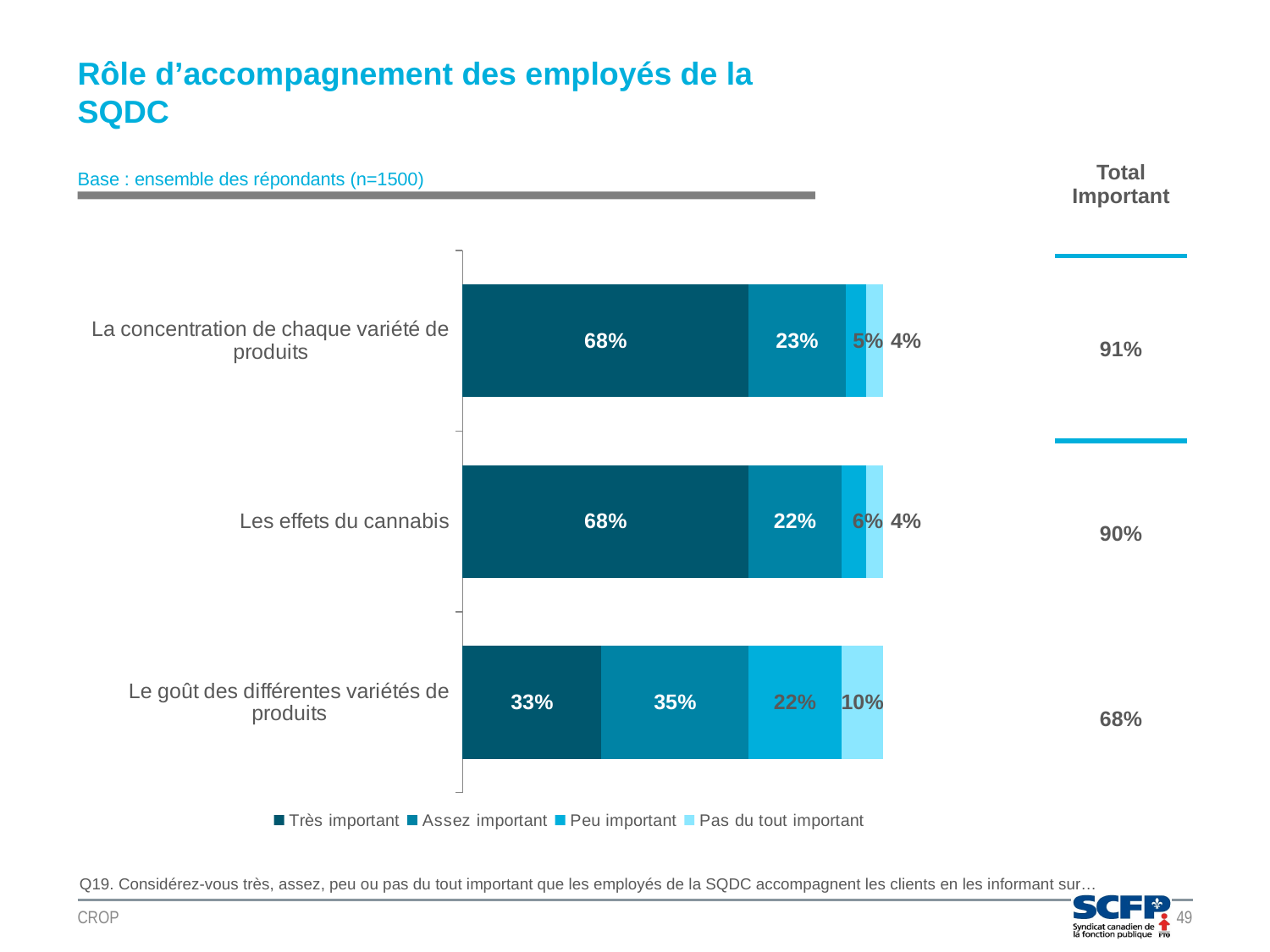
What is the 'Assez important' value for 'Le goût des différentes variétés de produits'? 35% What is the 'Pas du tout important' value for 'La concentration de chaque variété de produits'? 4% What is the 'Très important' value for 'Les effets du cannabis'? 68% How many categories are plotted in the chart? 3 What kind of chart is shown on the slide? stacked bar chart What is the difference between the 'Très important' values for 'Les effets du cannabis' and 'Le goût des différentes variétés de produits'? 35% Which category has the highest 'Pas du tout important' value? Le goût des différentes variétés de produits Which category has the lowest 'Très important' value? Le goût des différentes variétés de produits What is the 'Total Important' value shown for 'Le goût des différentes variétés de produits'? 68% What is the 'Peu important' value for 'Les effets du cannabis'? 6% How many series does the legend list? 4 Which is larger: the 'Assez important' value for 'La concentration de chaque variété de produits' or for 'Les effets du cannabis'? La concentration de chaque variété de produits